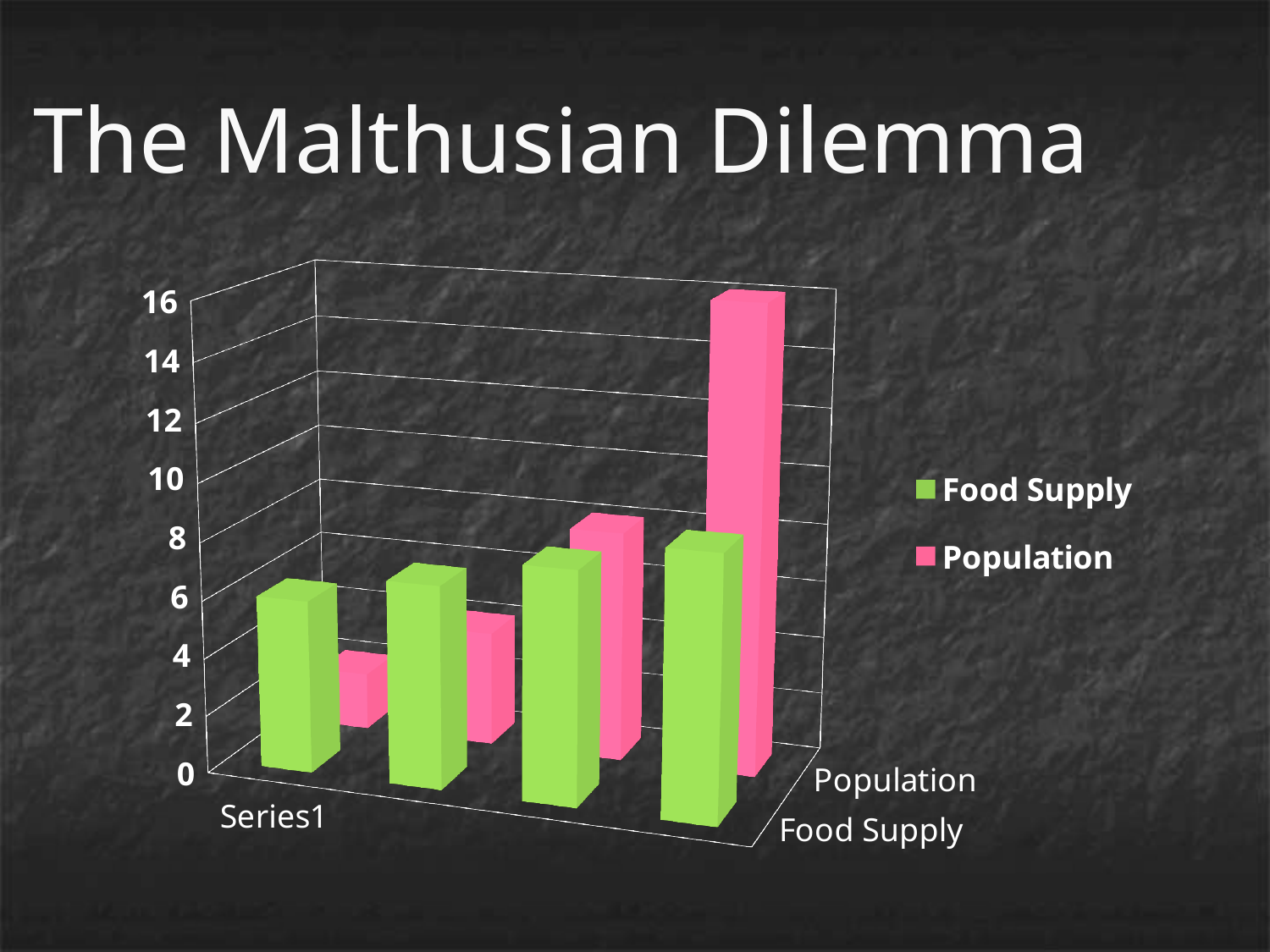
Which colour represents the Population series? pink What are the two series named in the legend? Food Supply and Population Do the Population bars rise or fall from left to right? rise Do the Food Supply bars rise or fall from left to right? rise In the rightmost group of bars, which is larger: Food Supply or Population? Population Is the value of the tallest Population bar greater or less than 12? greater How many series does the legend list? 2 In the leftmost group of bars (Series1), which is larger: Food Supply or Population? Food Supply Is the value of the leftmost Population bar greater or less than 6? less What kind of chart is shown on the slide? bar chart Which series contains the tallest bar on the chart? Population How many bars are plotted for the Population series? 4